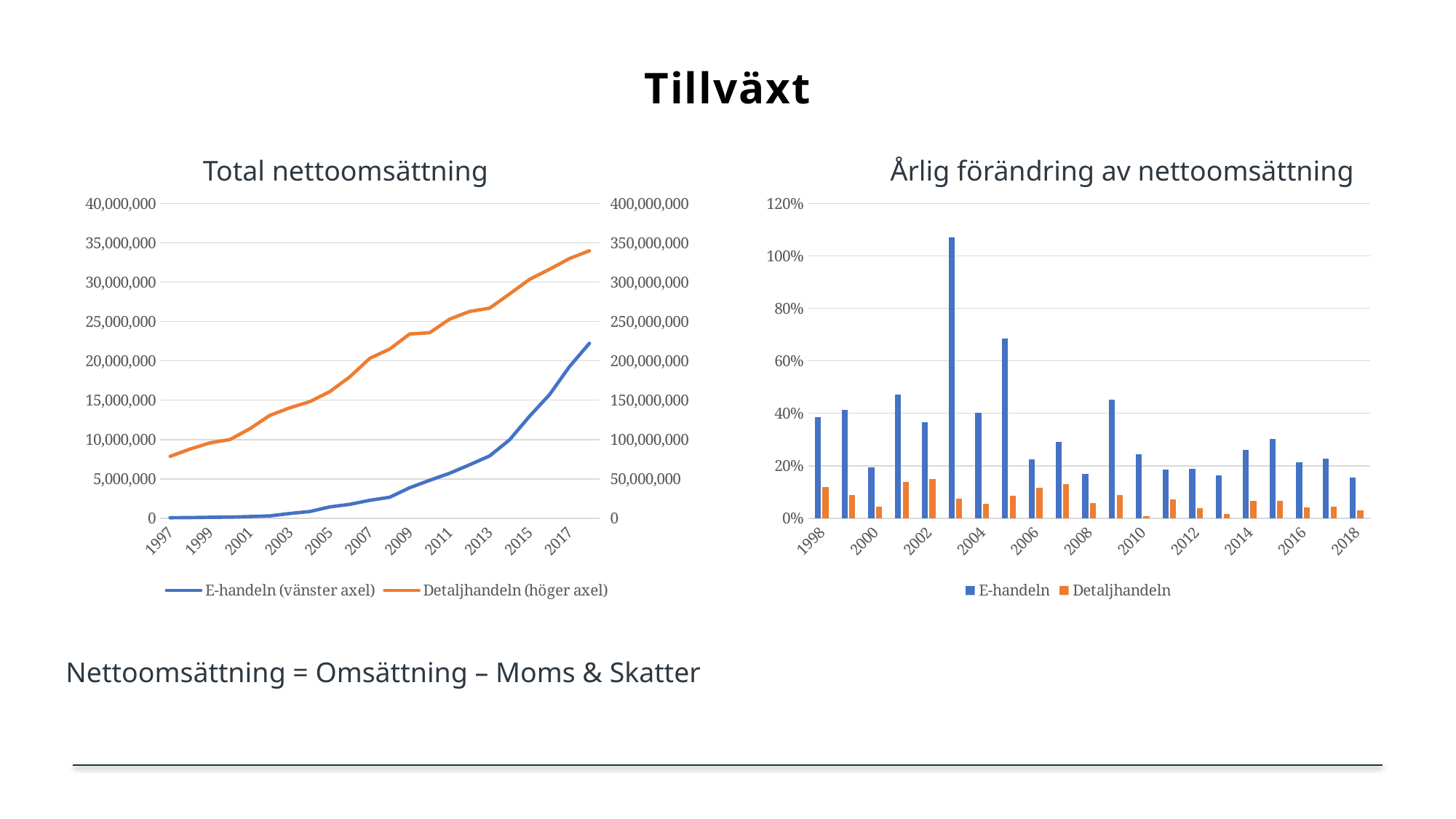
In the 'Årlig förändring av nettoomsättning' chart, is the E-handeln value for 2005 greater or less than 60%? greater What kind of chart is the 'Årlig förändring av nettoomsättning' chart on the right? bar chart What kind of chart is the 'Total nettoomsättning' chart on the left? line chart In the 'Total nettoomsättning' chart, how many series does the legend list? 2 In the 'Total nettoomsättning' chart, which axis does the Detaljhandeln series use according to the legend? höger axel In the 'Total nettoomsättning' chart, is the Detaljhandeln value for 2018 greater or less than 300,000,000? greater In the 'Total nettoomsättning' chart, does the E-handeln line rise or fall from 1997 to 2018? rise In the 'Total nettoomsättning' chart, is the E-handeln value for 2018 greater or less than 20,000,000? greater In the 'Årlig förändring av nettoomsättning' chart, which is larger in 2003, E-handeln or Detaljhandeln? E-handeln In the 'Årlig förändring av nettoomsättning' chart, how many series does the legend list? 2 In the 'Årlig förändring av nettoomsättning' chart, which year has the highest E-handeln value? 2003